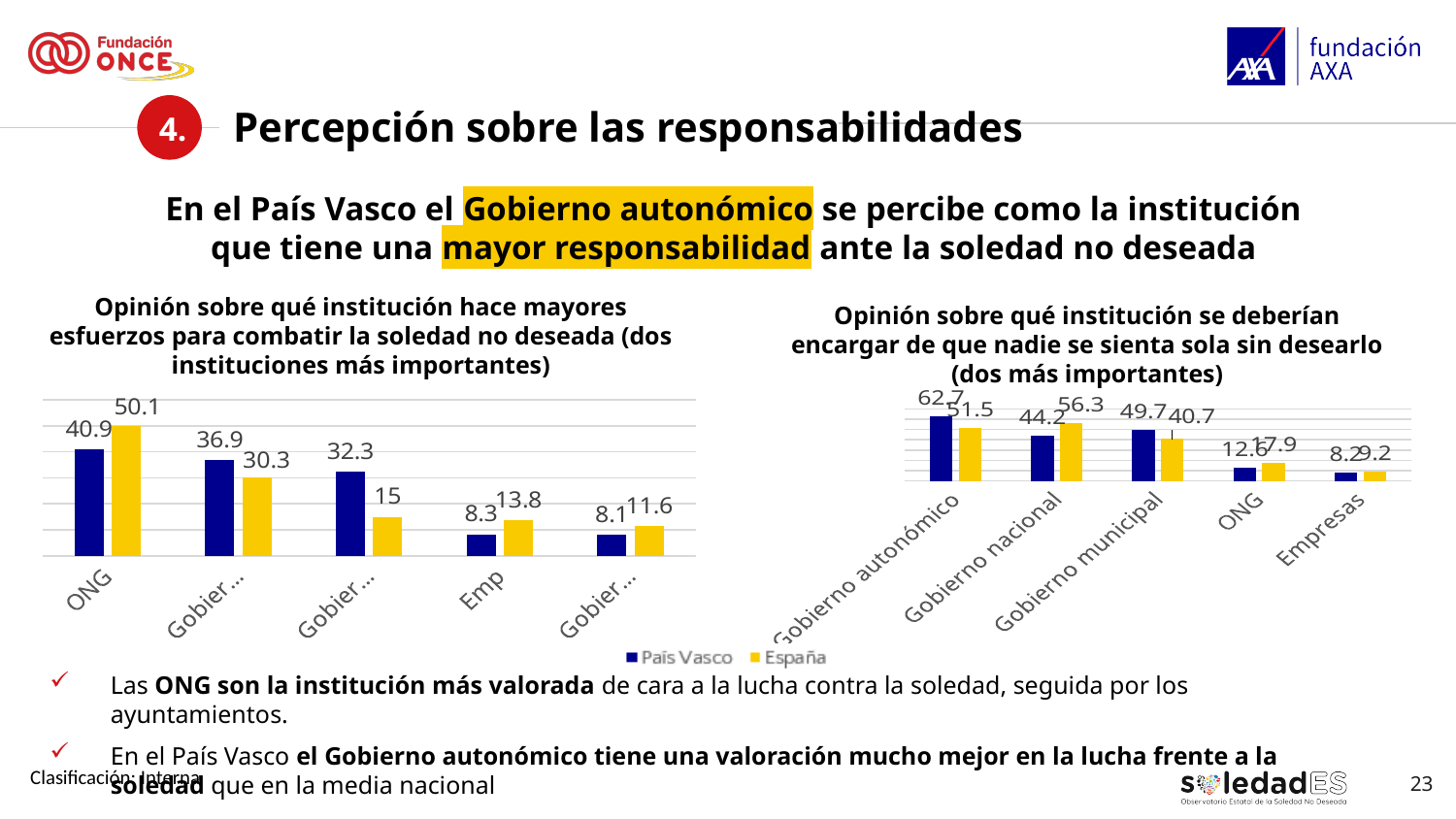
In the right chart (Opinión sobre qué institución se deberían encargar...), how much higher is the País Vasco value than the España value for Gobierno autonómico? 11.2 In the left chart (Opinión sobre qué institución hace mayores esfuerzos...), what is the difference between the España and País Vasco values for ONG? 9.2 In the right chart (Opinión sobre qué institución se deberían encargar...), for Gobierno nacional, which is larger: País Vasco or España? España In the left chart (Opinión sobre qué institución hace mayores esfuerzos...), what is the España value for ONG? 50.1 In the right chart (Opinión sobre qué institución se deberían encargar...), what is the País Vasco value for Gobierno autonómico? 62.7 In the left chart (Opinión sobre qué institución hace mayores esfuerzos...), what is the País Vasco value for ONG? 40.9 In the right chart (Opinión sobre qué institución se deberían encargar...), what is the País Vasco value for Gobierno municipal? 49.7 In the right chart (Opinión sobre qué institución se deberían encargar...), how many institutions are shown on the x axis? 5 In the right chart (Opinión sobre qué institución se deberían encargar...), which institution has the lowest España value? Empresas In the right chart (Opinión sobre qué institución se deberían encargar...), what is the España value for Gobierno nacional? 56.3 How many series does the legend on the slide list? 2 In the right chart (Opinión sobre qué institución se deberían encargar...), which institution has the highest País Vasco value? Gobierno autonómico